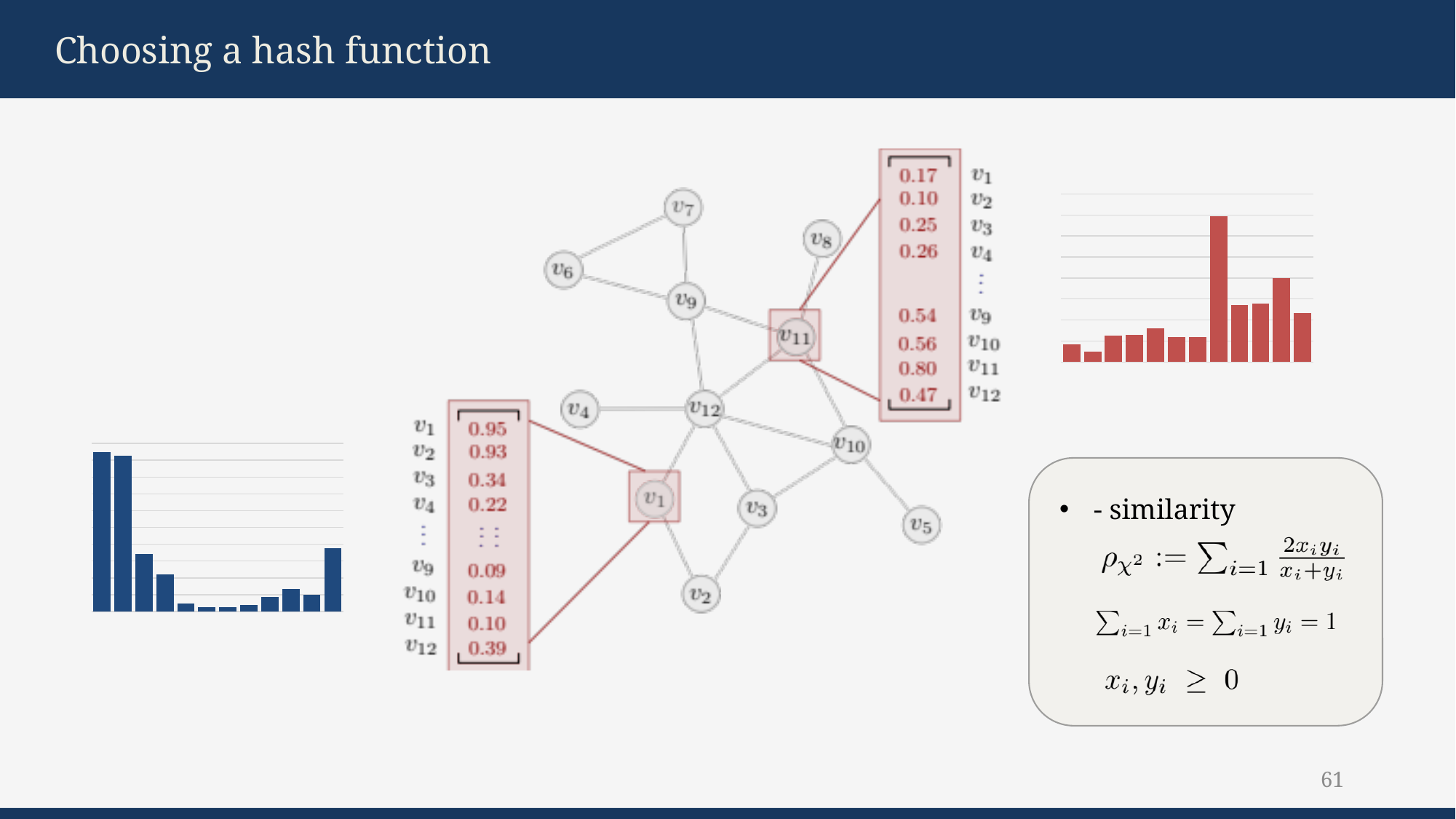
How many bar charts are shown on the slide? 2 What colour are the bars in the chart on the left of the slide? blue What kind of chart is the blue chart on the left of the slide? bar chart In the blue chart on the left of the slide, do the bars rise or fall from the 2nd bar to the 5th bar? fall What kind of chart is the red chart on the right of the slide? bar chart How many bars does the blue chart on the left of the slide have? 12 In the red chart on the right of the slide, is the leftmost bar taller or shorter than the rightmost bar? shorter In the red chart on the right of the slide, which bar (counting from the left) is the tallest? the 8th bar In the red chart on the right of the slide, is the 8th bar from the left taller or shorter than the 10th bar from the left? taller How many bars does the red chart on the right of the slide have? 12 In the blue chart on the left of the slide, is the leftmost bar taller or shorter than the rightmost bar? taller In the red chart on the right of the slide, which bar (counting from the left) is the shortest? the 2nd bar